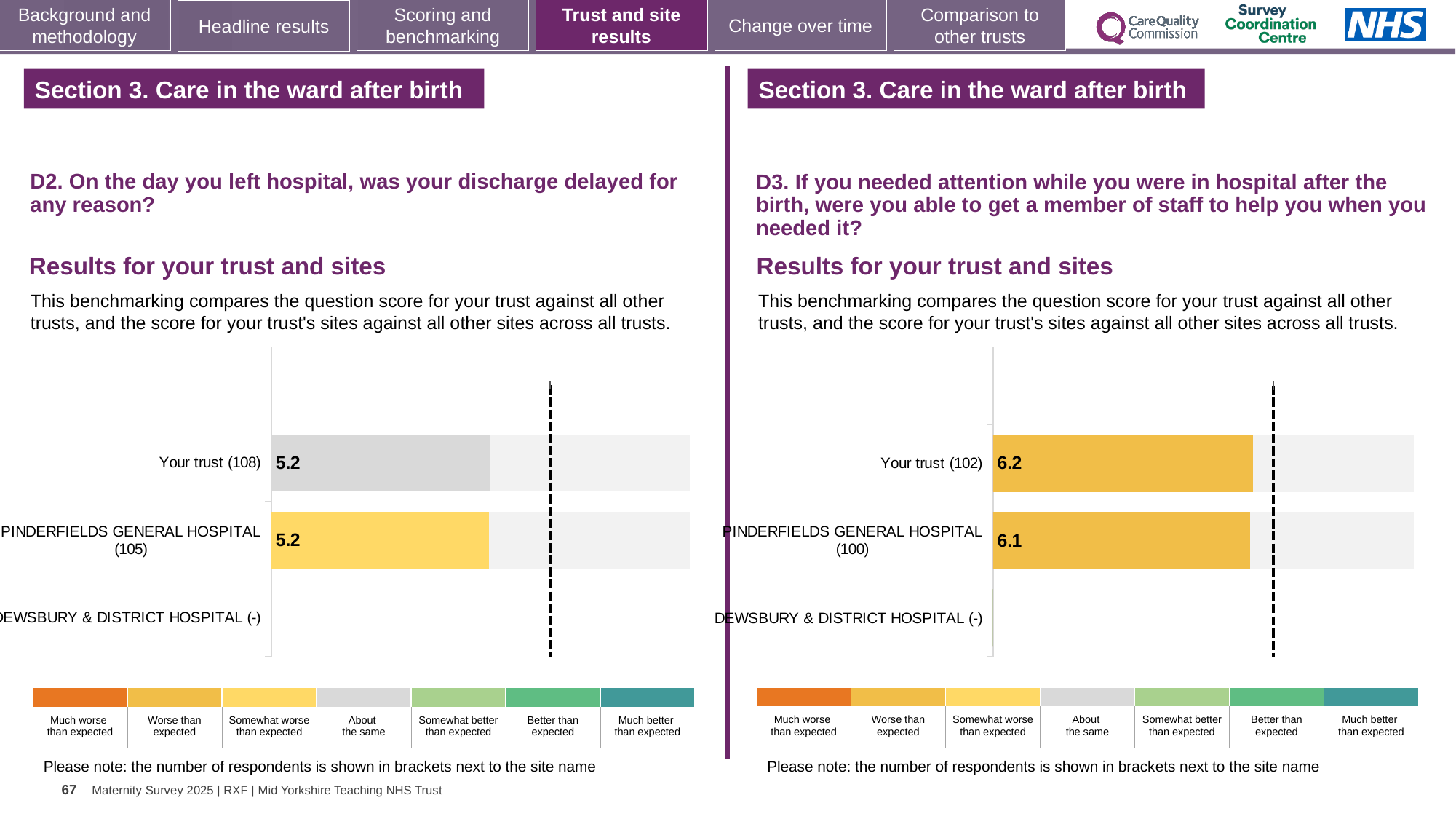
In the D2 chart on the left, which category has no bar plotted? DEWSBURY & DISTRICT HOSPITAL (-) In the D3 chart on the right, what is the score for Your trust (102)? 6.2 In the D3 chart on the right, how many respondents are shown in brackets for PINDERFIELDS GENERAL HOSPITAL? 100 What kind of chart is used in the D2 chart on the left? Bar chart In the D2 chart on the left, what is the score for Your trust (108)? 5.2 In the D3 chart on the right, what is the difference between the score for Your trust (102) and the score for PINDERFIELDS GENERAL HOSPITAL (100)? 0.1 How many categories are listed on the vertical axis of the D3 chart on the right? 3 Is the score for Your trust in the D3 chart on the right larger or smaller than the score for Your trust in the D2 chart on the left? Larger In the D3 chart on the right, what is the score for PINDERFIELDS GENERAL HOSPITAL (100)? 6.1 In the D2 chart on the left, what is the difference between the score for Your trust (108) and the score for PINDERFIELDS GENERAL HOSPITAL (105)? 0 In the D2 chart on the left, how many respondents are shown in brackets for Your trust? 108 In the D2 chart on the left, what is the score for PINDERFIELDS GENERAL HOSPITAL (105)? 5.2